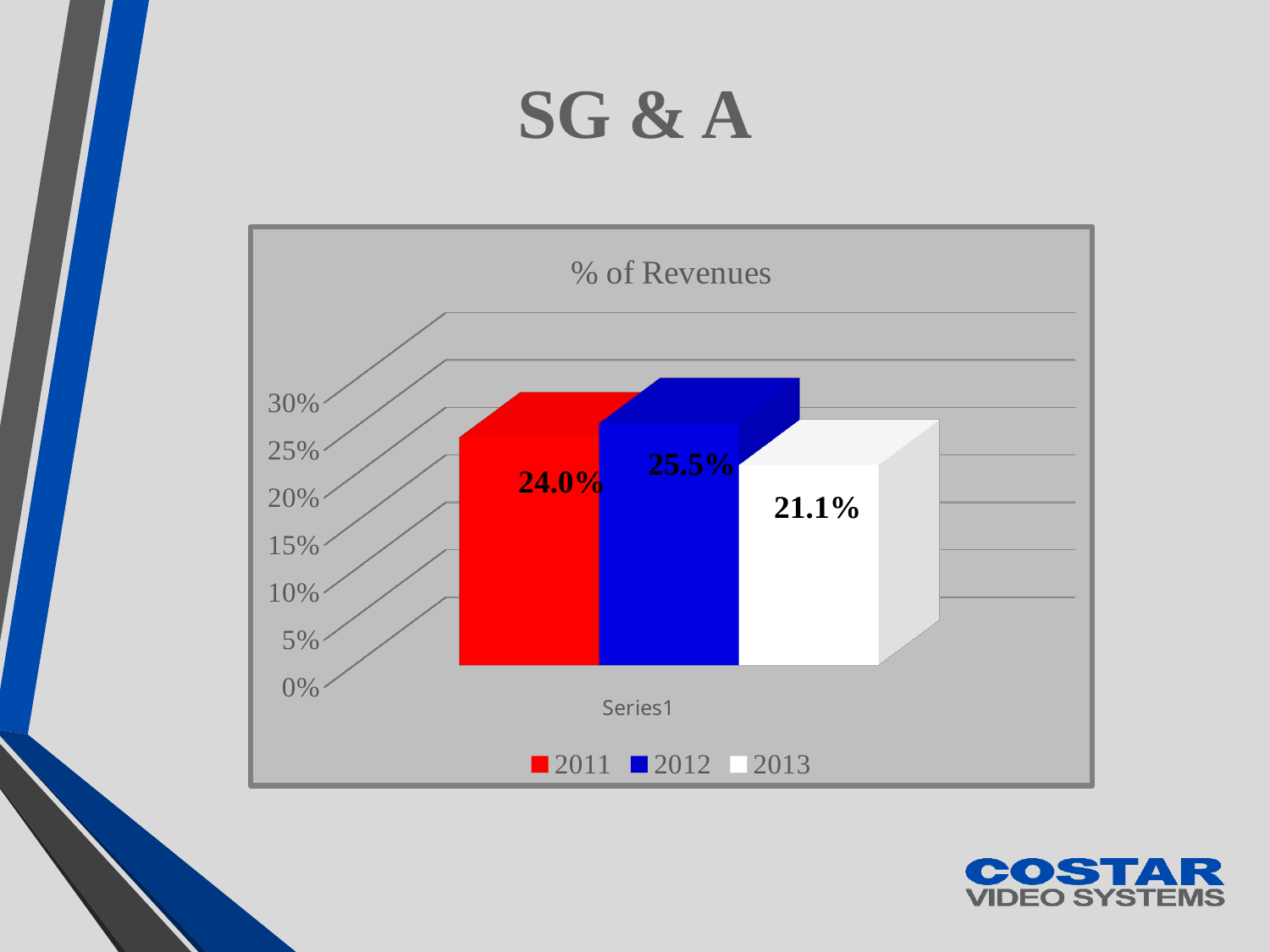
What is the title of the chart? % of Revenues What kind of chart is shown on the slide? bar chart How many series does the legend list? 3 What is the SG&A value for 2013 as a % of revenues? 21.1% Is the value for 2013 greater or less than 25%? less Which is larger, the value for 2011 or the value for 2013? 2011 Which year has the highest SG&A as a % of revenues? 2012 What is the difference between the 2012 and 2013 values? 4.4% What is the SG&A value for 2012 as a % of revenues? 25.5% What is the difference between the 2012 and 2011 values? 1.5% Which year has the lowest SG&A as a % of revenues? 2013 What is the SG&A value for 2011 as a % of revenues? 24.0%